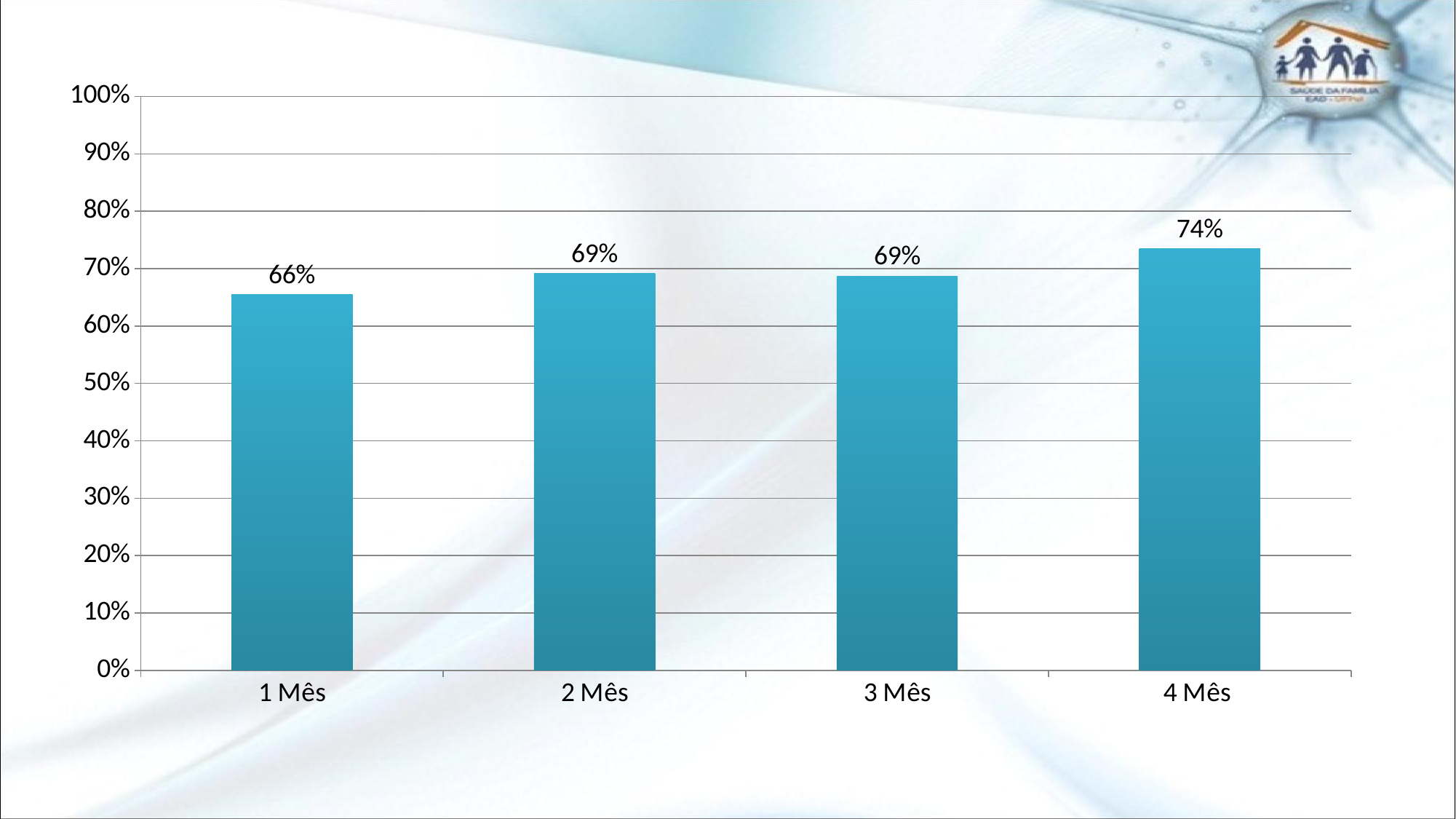
Which category has the lowest value? 1 Mês Is the value for 1 Mês greater or less than 70%? less Which category has the highest value? 4 Mês What is the highest value shown on the y axis? 100% Which is larger, the value for 4 Mês or the value for 2 Mês? 4 Mês What is the difference between the values for 4 Mês and 1 Mês? 8% How many categories are shown on the x axis? 4 What is the value for 4 Mês? 74% What kind of chart is shown on the slide? bar chart Is the value for 4 Mês greater or less than 70%? greater What is the value for 1 Mês? 66% What is the value for 2 Mês? 69%